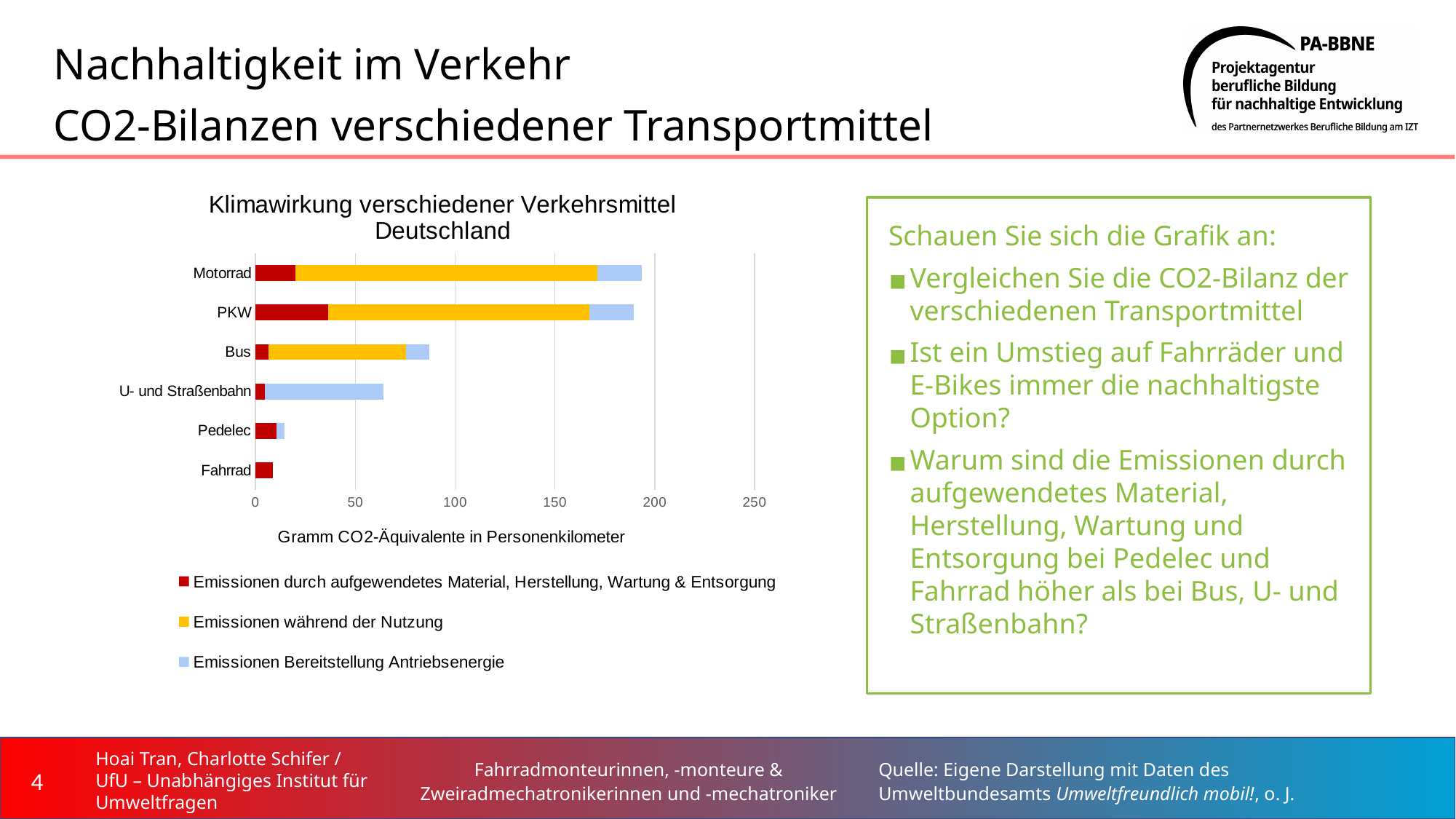
What is the title of the chart? Klimawirkung verschiedener Verkehrsmittel Deutschland Is the total value for Bus greater or less than 100? less Is the total value for PKW greater or less than 200? less What kind of chart is shown on the slide? bar chart Which has the larger total value, Bus or U- und Straßenbahn? Bus Is the total value for Pedelec greater or less than 50? less How many series does the chart legend list? 3 How many transport modes (categories) are shown in the chart? 6 Which has the larger total value, PKW or Bus? PKW What is the label of the horizontal axis of the chart? Gramm CO2-Äquivalente in Personenkilometer